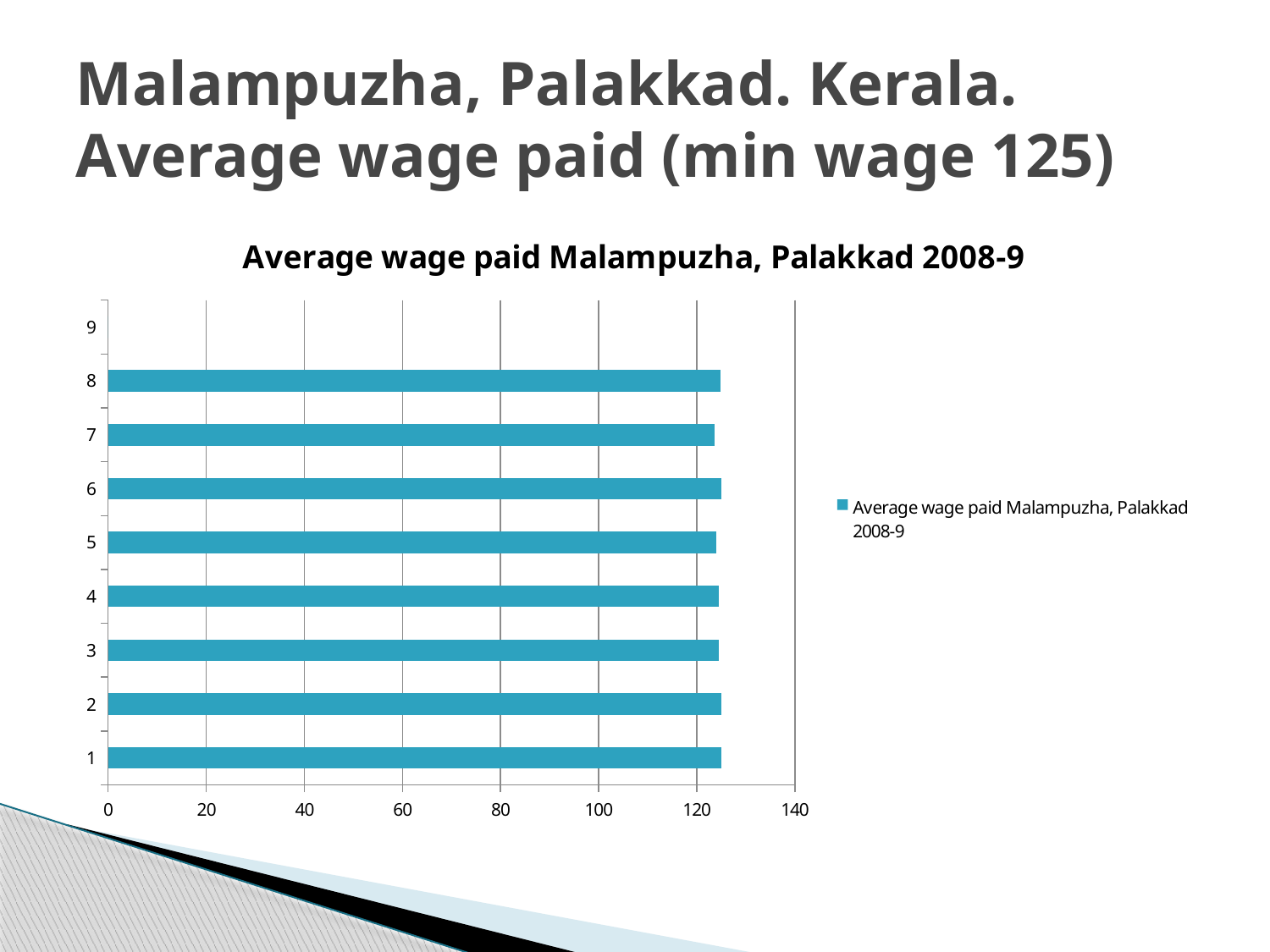
Is the value for category 7 greater or less than 100? greater How many categories are shown on the vertical axis of the chart? 9 Is the value for category 1 greater or less than 120? greater What is the highest value shown on the horizontal axis of the chart? 140 Is the value for category 8 greater or less than 140? less Which category has the lowest value in the chart? 9 Which is larger, the value for category 2 or the value for category 9? category 2 How many series does the legend list? 1 What kind of chart is shown on the slide? bar chart What is the title of the chart? Average wage paid Malampuzha, Palakkad 2008-9